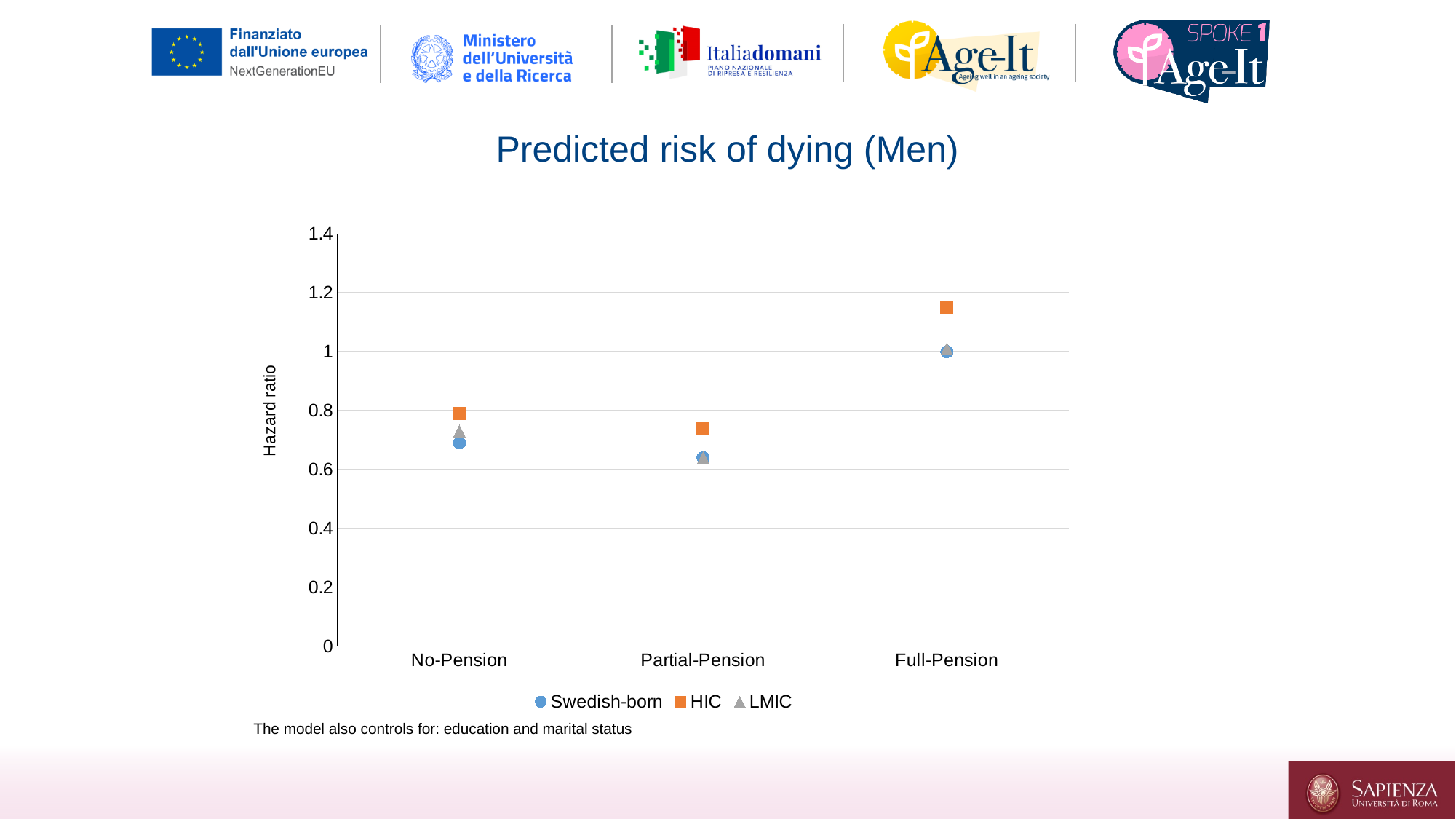
Which series has the lowest hazard ratio at No-Pension? Swedish-born Is the hazard ratio for Swedish-born at No-Pension greater or less than 0.8? less What is the label of the y axis? Hazard ratio Is the hazard ratio for HIC at Full-Pension greater or less than 1? greater What is the hazard ratio for Swedish-born at Full-Pension? 1 What kind of chart is shown on the slide? Scatter chart How many pension categories are shown on the x axis? 3 How many series does the legend list? 3 Which is larger for HIC: the hazard ratio at No-Pension or at Full-Pension? Full-Pension Which series has the highest hazard ratio at Full-Pension? HIC Is the hazard ratio for HIC at Partial-Pension greater or less than 0.6? greater What is the title of the chart? Predicted risk of dying (Men)